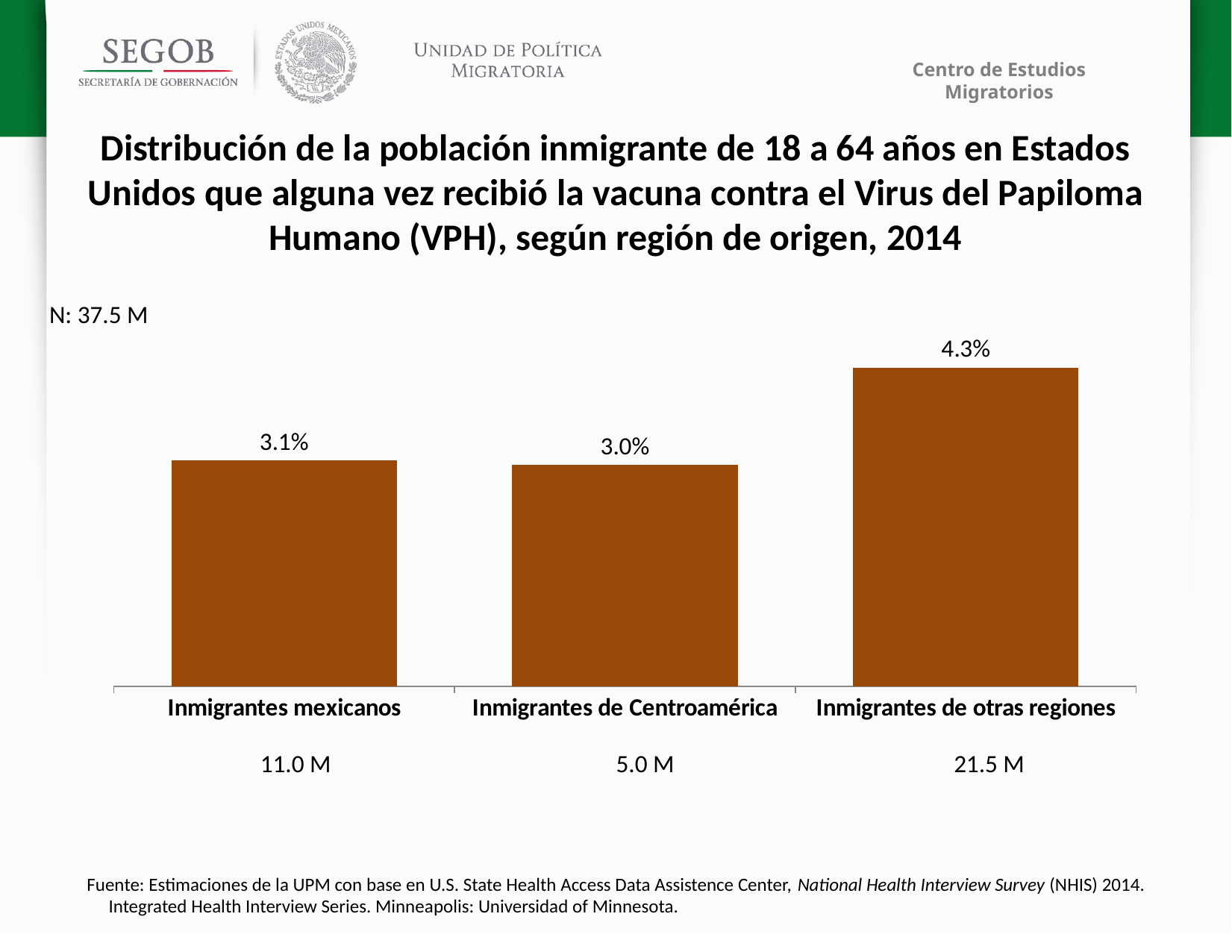
What population size (N) is shown for the chart? 37.5 M What is the value for Inmigrantes de otras regiones? 4.3% Which category has the highest value? Inmigrantes de otras regiones What is the value for Inmigrantes mexicanos? 3.1% What is the difference between the values for Inmigrantes de otras regiones and Inmigrantes mexicanos? 1.2% What is the value for Inmigrantes de Centroamérica? 3.0% What is the difference between the values for Inmigrantes mexicanos and Inmigrantes de Centroamérica? 0.1% How many categories are shown in the chart? 3 Which is larger, the value for Inmigrantes de otras regiones or the value for Inmigrantes de Centroamérica? Inmigrantes de otras regiones What kind of chart is shown on the slide? bar chart What population figure is shown below the Inmigrantes de otras regiones bar? 21.5 M What population figure is shown below the Inmigrantes de Centroamérica bar? 5.0 M